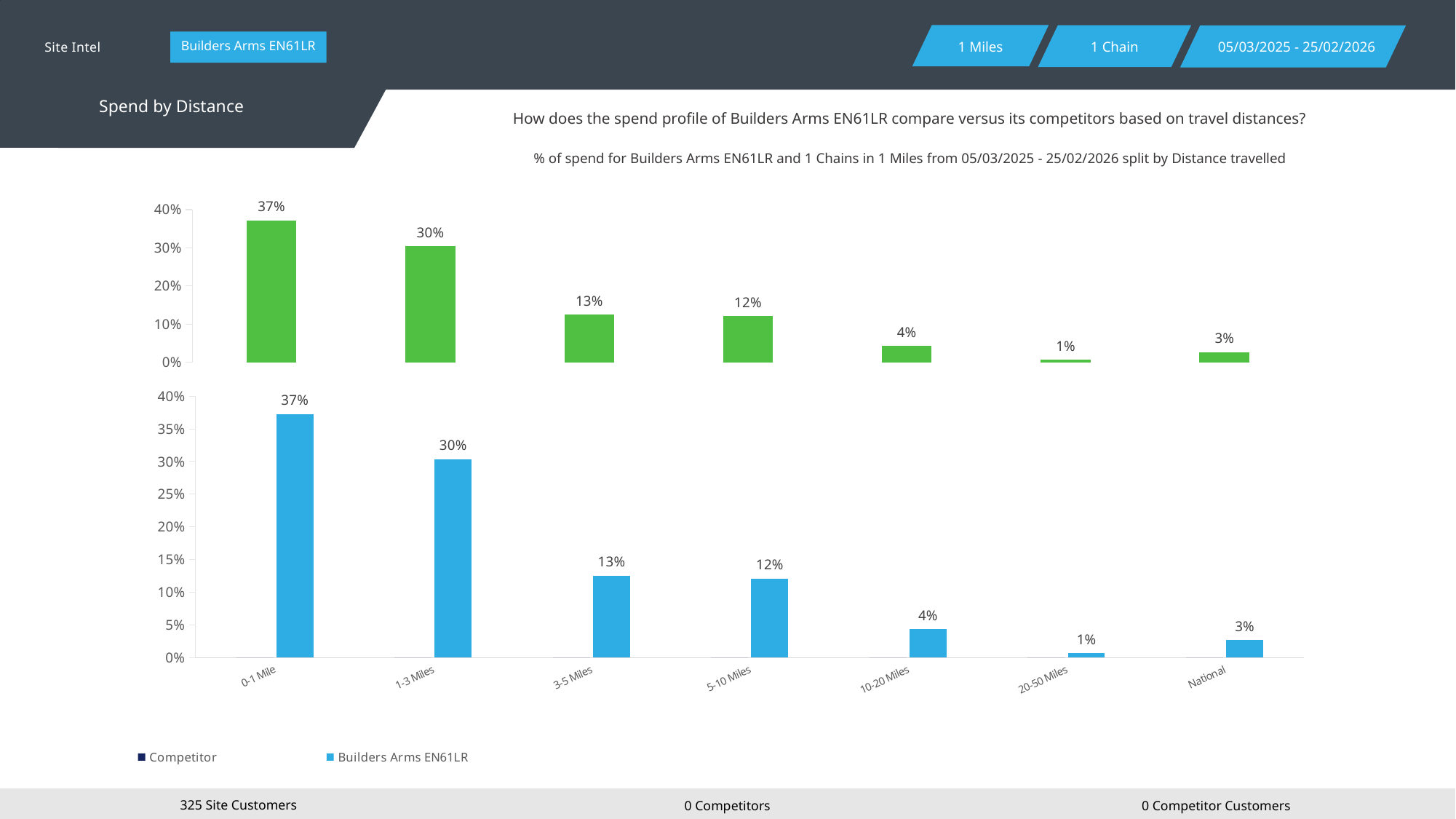
In the bottom chart, what is the value for 10-20 Miles? 4% In the bottom chart, which is larger, the value for 3-5 Miles or the value for 5-10 Miles? 3-5 Miles In the bottom chart, what is the value for National? 3% In the bottom chart, which category has the highest value? 0-1 Mile How many series does the legend below the bottom chart list? 2 What kind of chart is the bottom chart? Bar chart In the bottom chart, what is the difference between the values for 0-1 Mile and 1-3 Miles? 7% How many categories are shown on the x axis of the bottom chart? 7 In the bottom chart, what is the value for 0-1 Mile? 37% In the bottom chart, which category has the lowest value? 20-50 Miles In the bottom chart, what is the value for 1-3 Miles? 30%